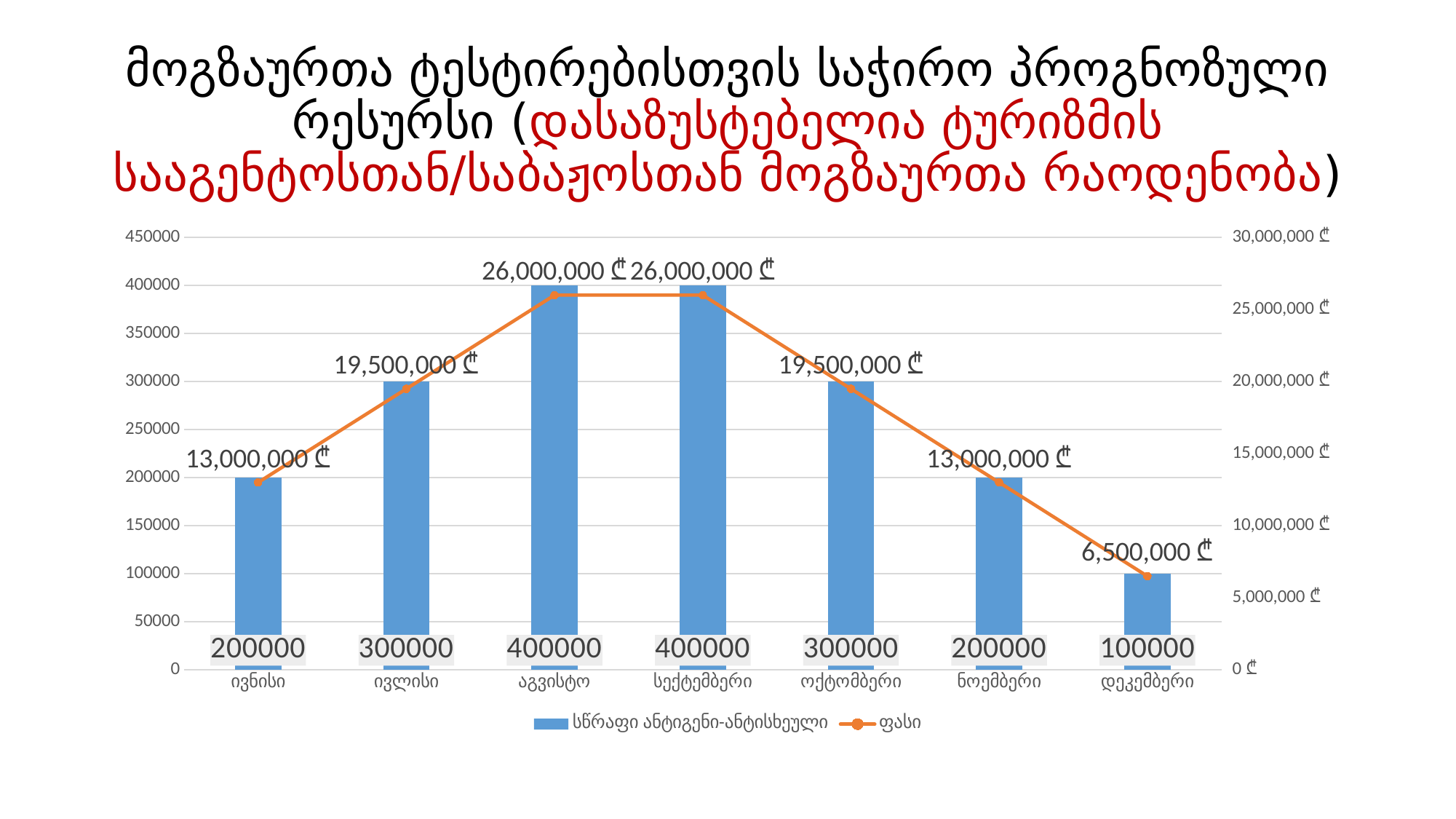
Which category has the lowest სწრაფი ანტიგენი-ანტისხეული bar? დეკემბერი Which has a larger სწრაფი ანტიგენი-ანტისხეული value, ივნისი or ოქტომბერი? ოქტომბერი What is the highest ფასი value shown on the chart? 26,000,000 ₾ What is the value of the სწრაფი ანტიგენი-ანტისხეული bar for ივლისი? 300000 How many series does the legend list? 2 What is the ფასი value for ოქტომბერი? 19,500,000 ₾ What is the difference between the სწრაფი ანტიგენი-ანტისხეული values for აგვისტო and ივნისი? 200000 What is the difference between the ფასი values for ივლისი and ნოემბერი? 6,500,000 ₾ What is the ფასი value for დეკემბერი? 6,500,000 ₾ What kind of chart is shown on the slide? Combined bar and line chart How does the ფასი line change from სექტემბერი to დეკემბერი? It falls How many categories are shown on the x axis? 7